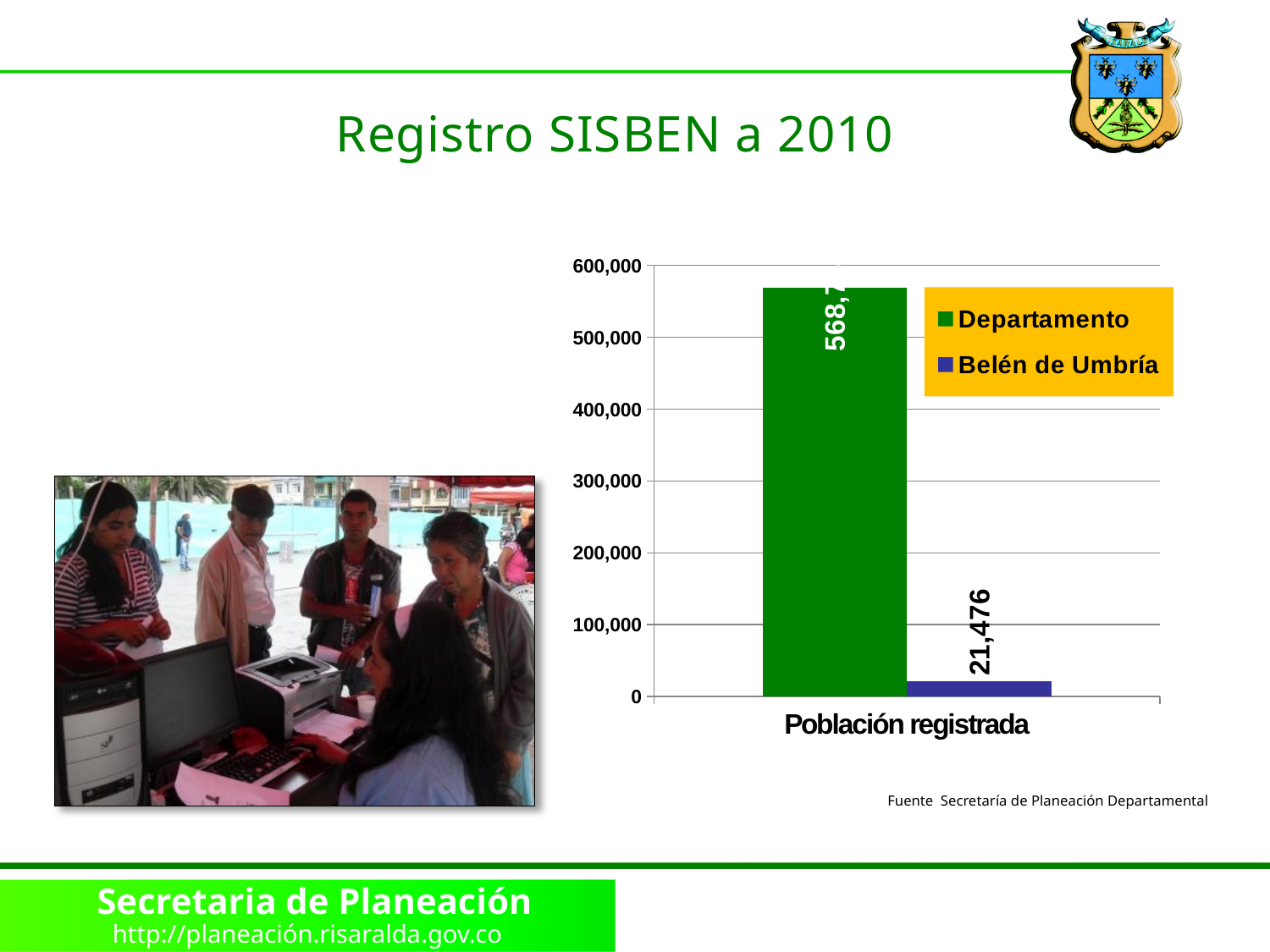
Is the value for Departamento greater or less than 500,000? greater What is the category label on the x axis of the chart? Población registrada What is the highest value shown on the y axis of the chart? 600,000 Which series has the lower value for Población registrada? Belén de Umbría How many categories are shown on the x axis? 1 What is the value for Belén de Umbría in the Población registrada chart? 21,476 Is the value for Belén de Umbría greater or less than 100,000? less What kind of chart is shown on the slide? bar chart How many series does the legend list? 2 Which series has the higher value for Población registrada? Departamento What colour represents Departamento in the chart? green Which is larger, the value for Departamento or the value for Belén de Umbría? Departamento